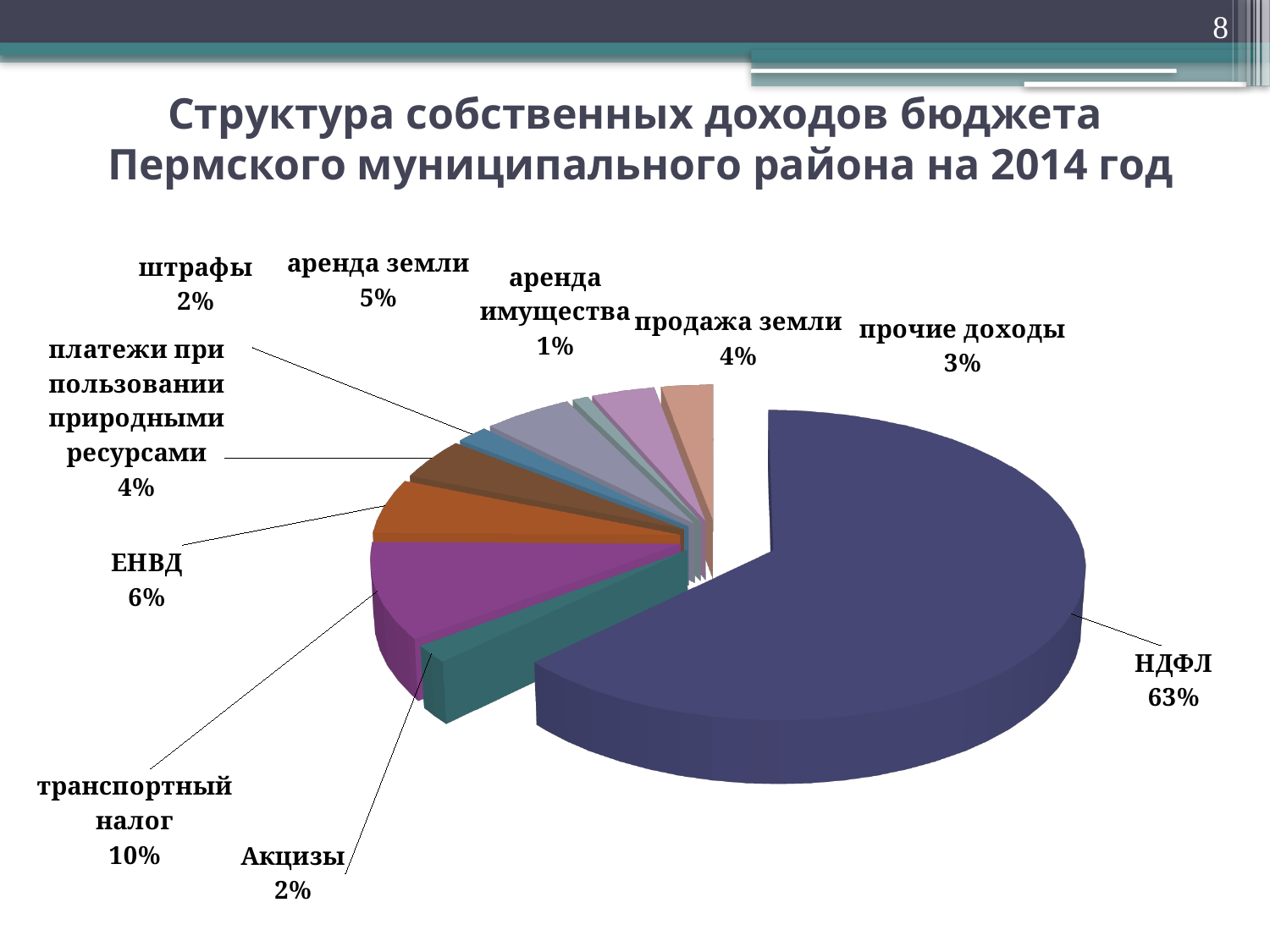
What is the title of the chart on the slide? Структура собственных доходов бюджета Пермского муниципального района на 2014 год Which is larger, the share of ЕНВД or the share of продажа земли? ЕНВД What is the value shown for аренда земли? 5% Which category has the smallest share of the pie? аренда имущества How many categories are shown in the pie chart? 10 What is the value shown for транспортный налог? 10% What is the value shown for ЕНВД? 6% What share of the budget's own revenues does НДФЛ account for? 63% What kind of chart is shown on the slide? pie chart What is the difference between the shares of НДФЛ and транспортный налог? 53% Which category has the largest share of the pie? НДФЛ What is the value shown for аренда имущества? 1%